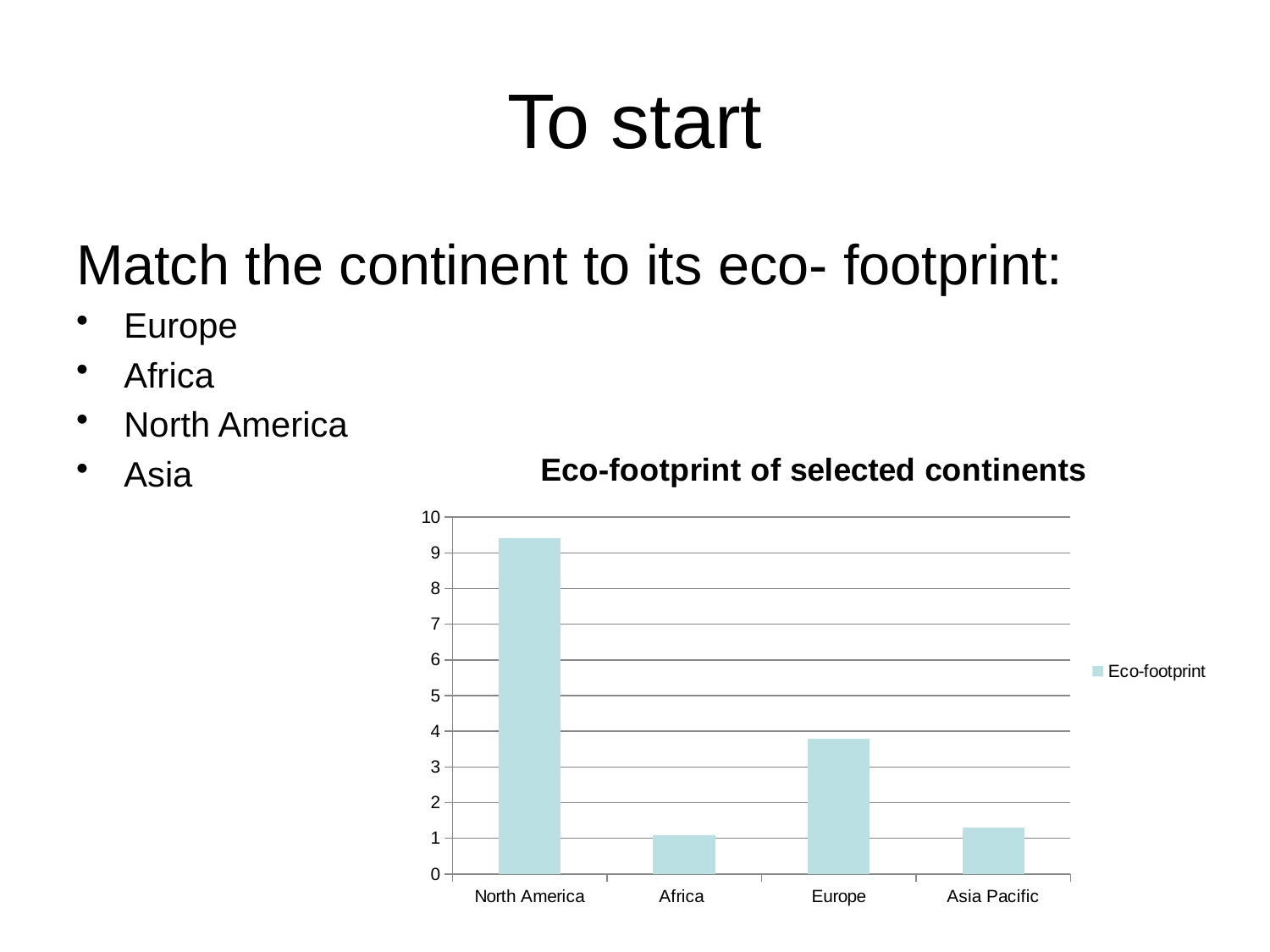
Which has the larger eco-footprint, North America or Europe? North America Is the value for Asia Pacific greater or less than 2? less Is the value for Europe greater or less than 3? greater What is the title of the chart? Eco-footprint of selected continents What series name is shown in the chart's legend? Eco-footprint Which continent has the highest eco-footprint in the chart? North America Is the value for Africa greater or less than 2? less How many continents are plotted in the chart? 4 What kind of chart is shown on the slide? bar chart Which has the larger eco-footprint, Europe or Africa? Europe How many series does the chart's legend list? 1